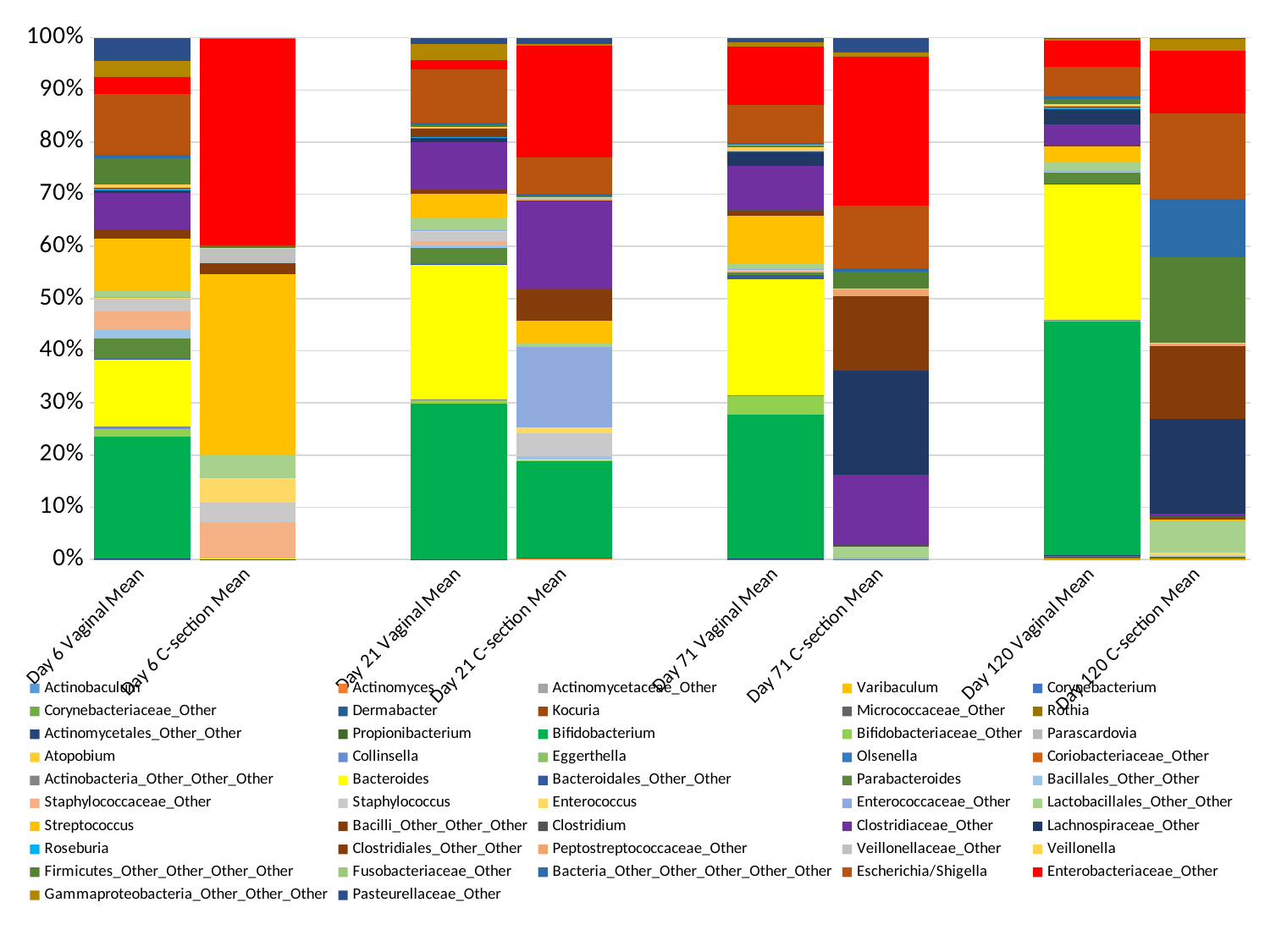
Is the Bifidobacterium share for Day 120 C-section Mean greater or less than 10%? less How many categories (bars) are plotted along the x axis? 8 What kind of chart is shown on the slide? Stacked bar chart Which has the larger Bifidobacterium share: Day 120 Vaginal Mean or Day 120 C-section Mean? Day 120 Vaginal Mean What is the total height of each stacked bar, as shown on the y axis? 100% Which category has the largest Bifidobacterium share? Day 120 Vaginal Mean How many series does the legend list? 47 Is the Streptococcus share for Day 6 C-section Mean greater or less than 30%? greater Is the Enterobacteriaceae_Other share for Day 6 C-section Mean greater or less than 30%? greater What colour represents Bifidobacterium in the legend? Green